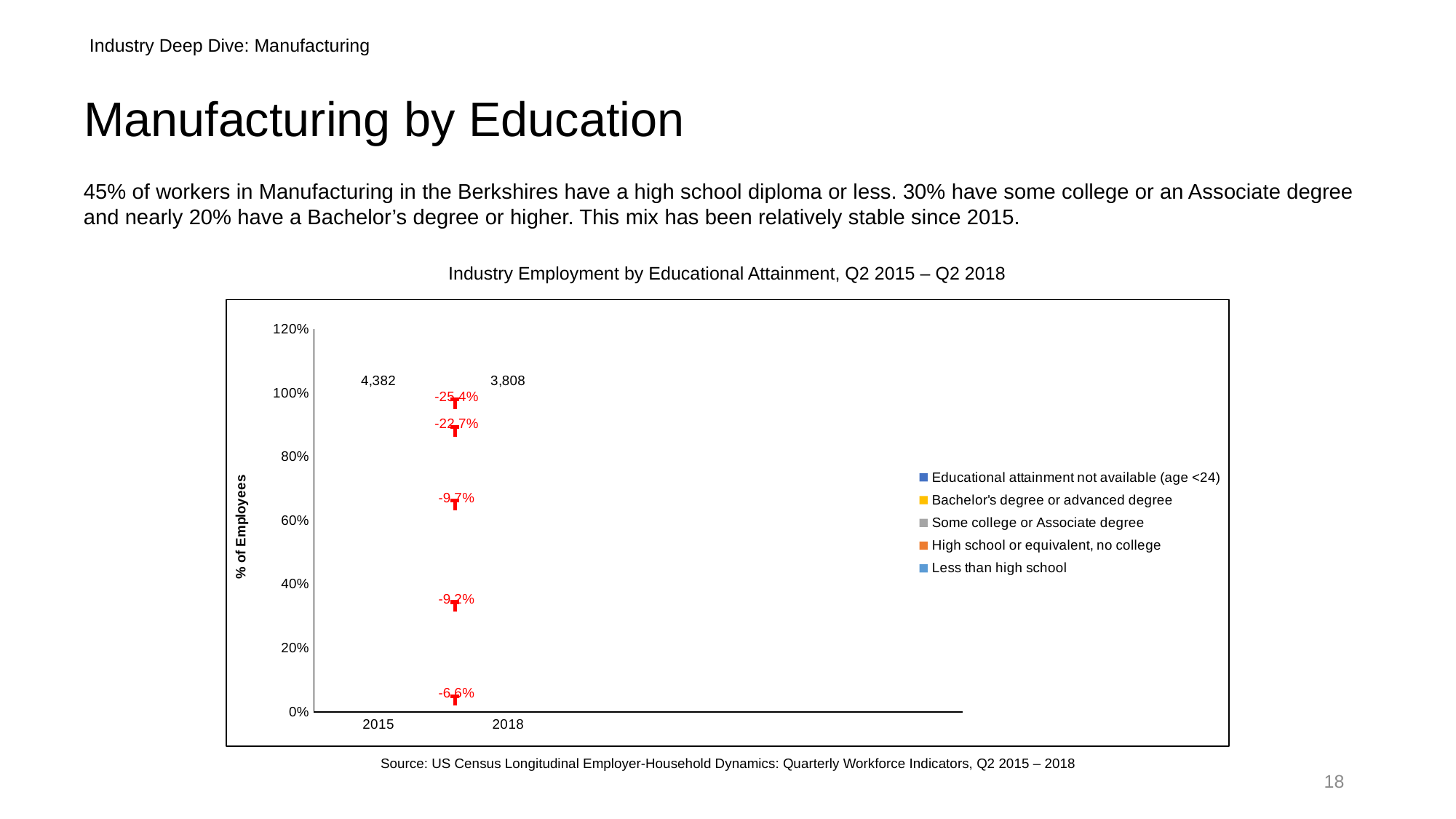
Does the employment count label fall or rise from 2015 to 2018? fall Which year has the larger employment count label, 2015 or 2018? 2015 How many years are shown on the x axis of the chart? 2 What is the difference between the employment count labels for 2015 and 2018? 574 What is the largest percentage change shown in red on the chart? -25.4% What is the title of the chart? Industry Employment by Educational Attainment, Q2 2015 – Q2 2018 What is the label on the y axis of the chart? % of Employees How many series does the chart's legend list? 5 What is the smallest percentage change shown in red on the chart? -6.6% What is the employment count label shown above the 2018 bar? 3,808 What is the employment count label shown above the 2015 bar? 4,382 How many red percentage-change labels are shown on the chart? 5